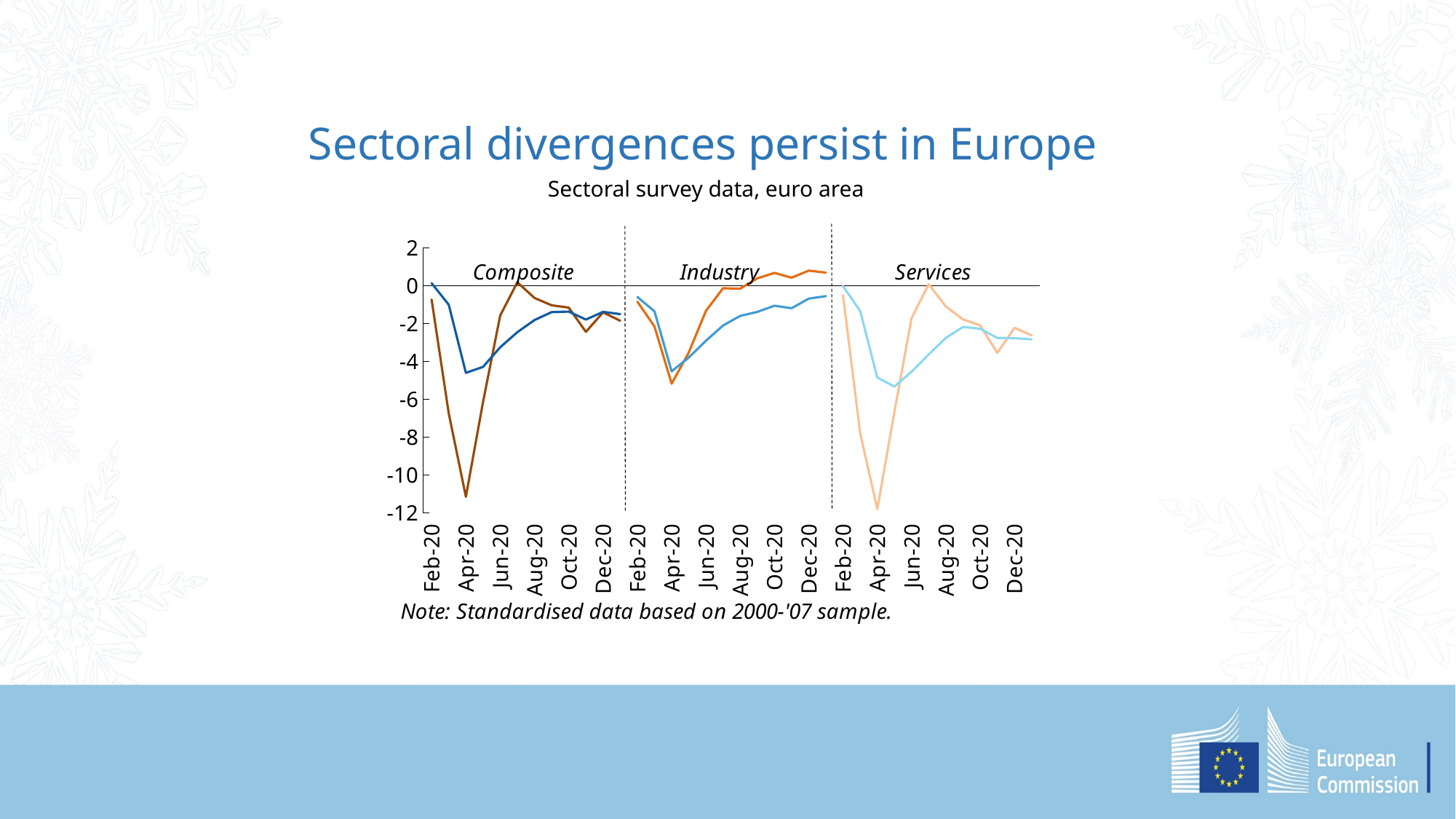
In the Composite panel, do both lines rise or fall between Feb-20 and Apr-20? fall What is the title of the slide? Sectoral divergences persist in Europe How many lines are plotted in the Composite panel? 2 What is the subtitle printed above the chart? Sectoral survey data, euro area In the Industry panel, is the value of the orange line in Apr-20 greater or less than -4? less How many month labels appear on the x axis of each panel? 6 How many panels (sectors) does the chart show? 3 In the Services panel, is the value of the orange line in Apr-20 greater or less than -10? less What kind of chart is shown on the slide? line chart In the Industry panel, is the value of the orange line in Dec-20 greater or less than 0? greater In the Industry panel, does the orange line rise or fall between Apr-20 and Dec-20? rise